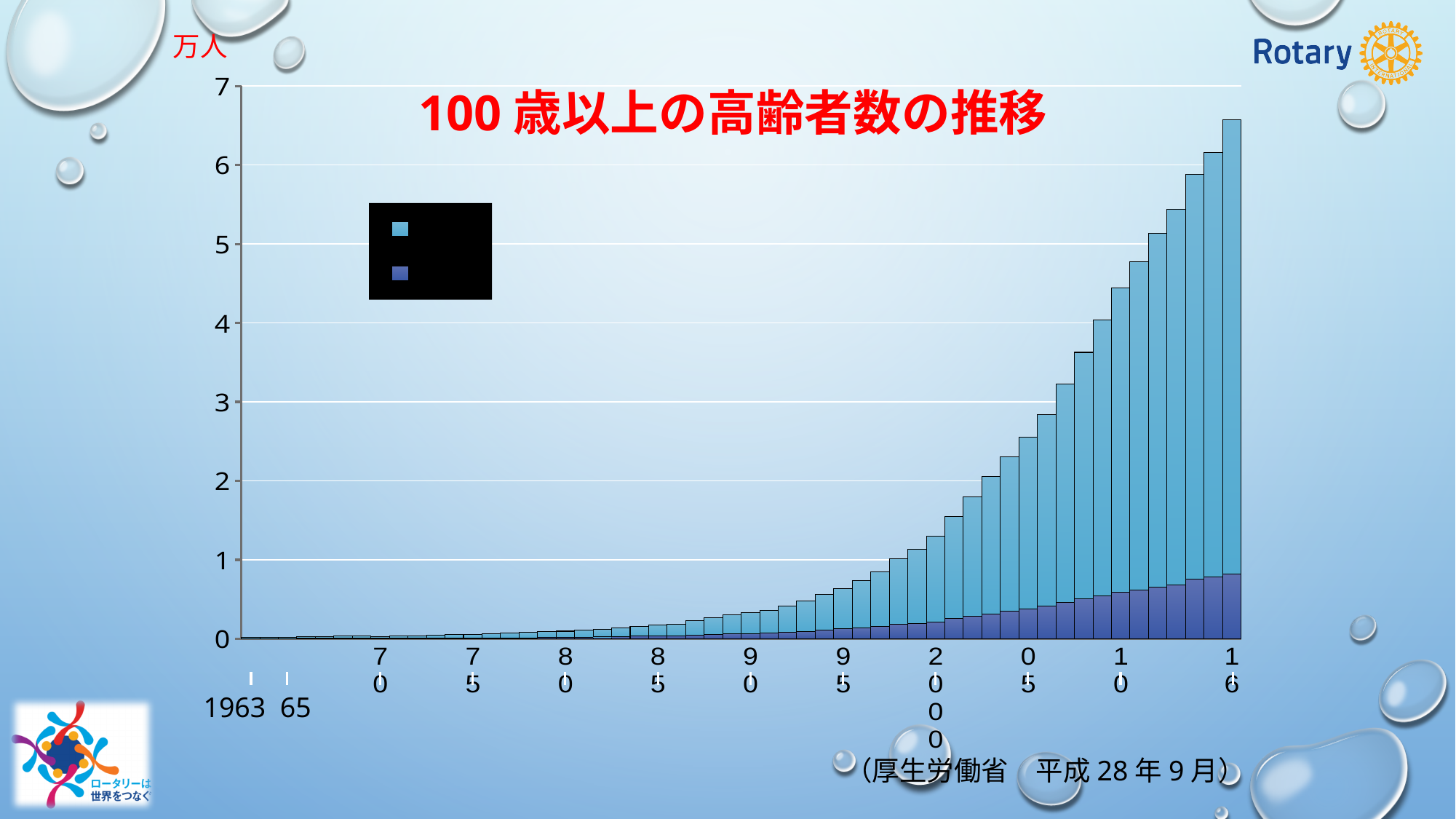
Which year has the larger total bar, 2000 or 2010? 2010 Is the total value for 2010 greater or less than 4? greater How many series does the legend list? 2 What unit is shown on the vertical axis of the chart? 万人 Is the total value for 2005 greater or less than 2? greater Do the total bar heights rise or fall from 1963 to 2016? rise Is the total value for 1990 greater or less than 1? less What kind of chart is shown on the slide? stacked bar chart What is the title of the chart? 100歳以上の高齢者数の推移 Which year has the tallest bar? 2016 Which year has the shortest bar? 1963